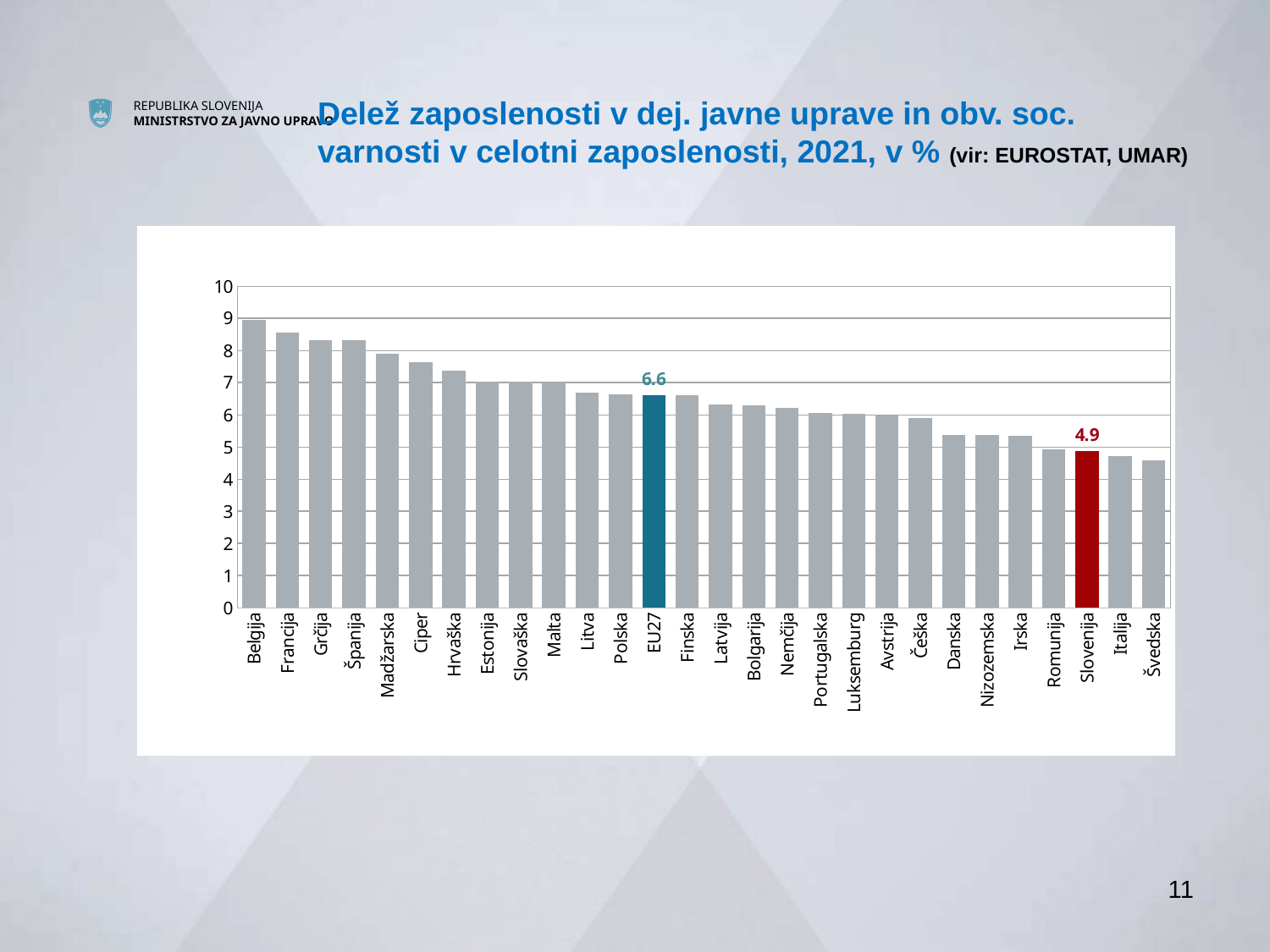
What value is shown for EU27? 6.6 How many bars are shown in the chart? 28 Do the values rise or fall from left to right along the x axis? Fall Is the value for Italija greater or less than 5? less Which has a larger value, Francija or Slovenija? Francija What value is shown for Slovenija? 4.9 What is the difference between the EU27 value and the Slovenija value? 1.7 Is the value for Madžarska greater or less than 7? greater What kind of chart is shown on the slide? Bar chart Which country has the highest value in the chart? Belgija Is the value for Nemčija greater or less than 6? greater Which has a larger value, Danska or Madžarska? Madžarska